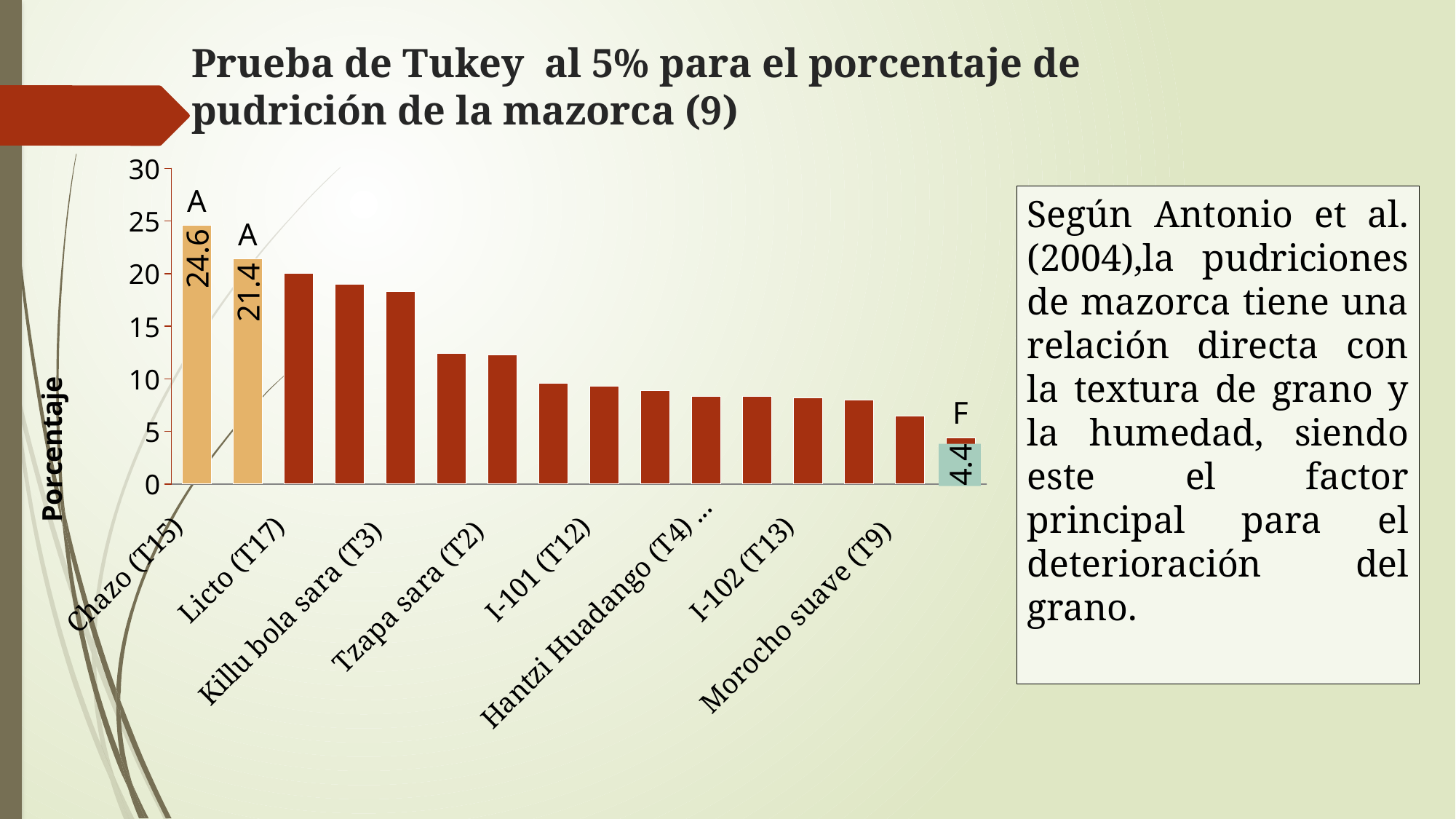
What is the title of the vertical axis? Porcentaje How many bars are plotted in the chart? 16 Which category has the highest bar in the chart? Chazo (T15) What is the difference between the first bar (24.6) and the second bar (21.4)? 3.2 What value is printed on the rightmost bar of the chart? 4.4 What is the difference between the value for Chazo (T15) and the value of the rightmost bar? 20.2 Is the value for Chazo (T15) greater or less than 20? greater Which is larger, the value for Chazo (T15) or the value of the rightmost bar? Chazo (T15) Do the bar values rise or fall from left to right along the x axis? fall What kind of chart is shown on the slide? bar chart What value is printed on the second bar from the left? 21.4 What is the value shown for Chazo (T15)? 24.6